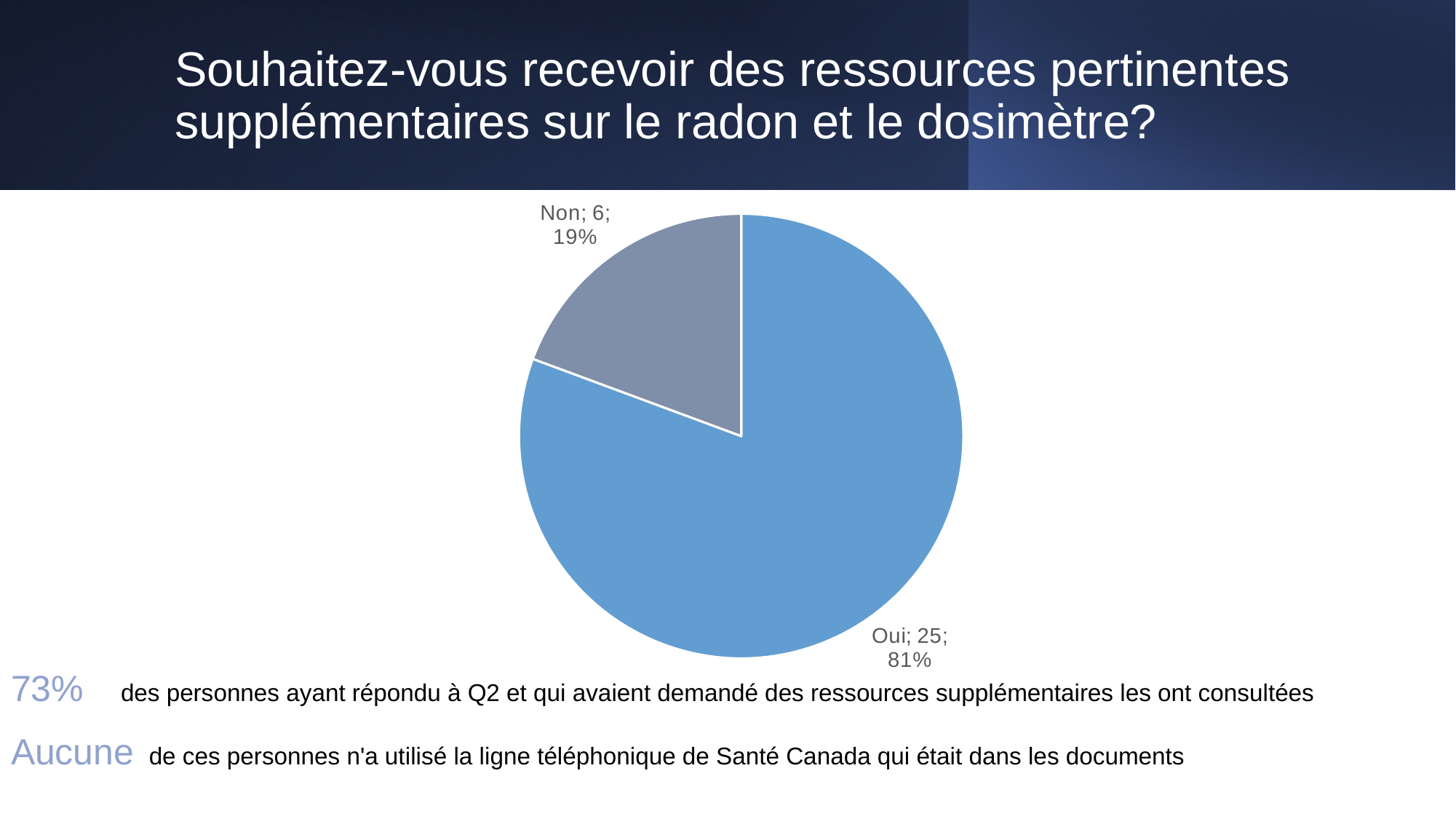
How many respondents answered "Oui"? 25 Which is larger, the "Oui" slice or the "Non" slice? Oui Which category has the smallest slice of the pie? Non What share of the pie does the "Oui" slice represent? 81% What share of the pie does the "Non" slice represent? 19% Which category has the largest slice of the pie? Oui What is the total number of responses shown in the pie chart? 31 What is the difference between the number of "Oui" and "Non" responses? 19 How many categories are shown in the pie chart? 2 What colour is the "Non" slice of the pie? grey How many respondents answered "Non"? 6 What kind of chart is shown on the slide? pie chart